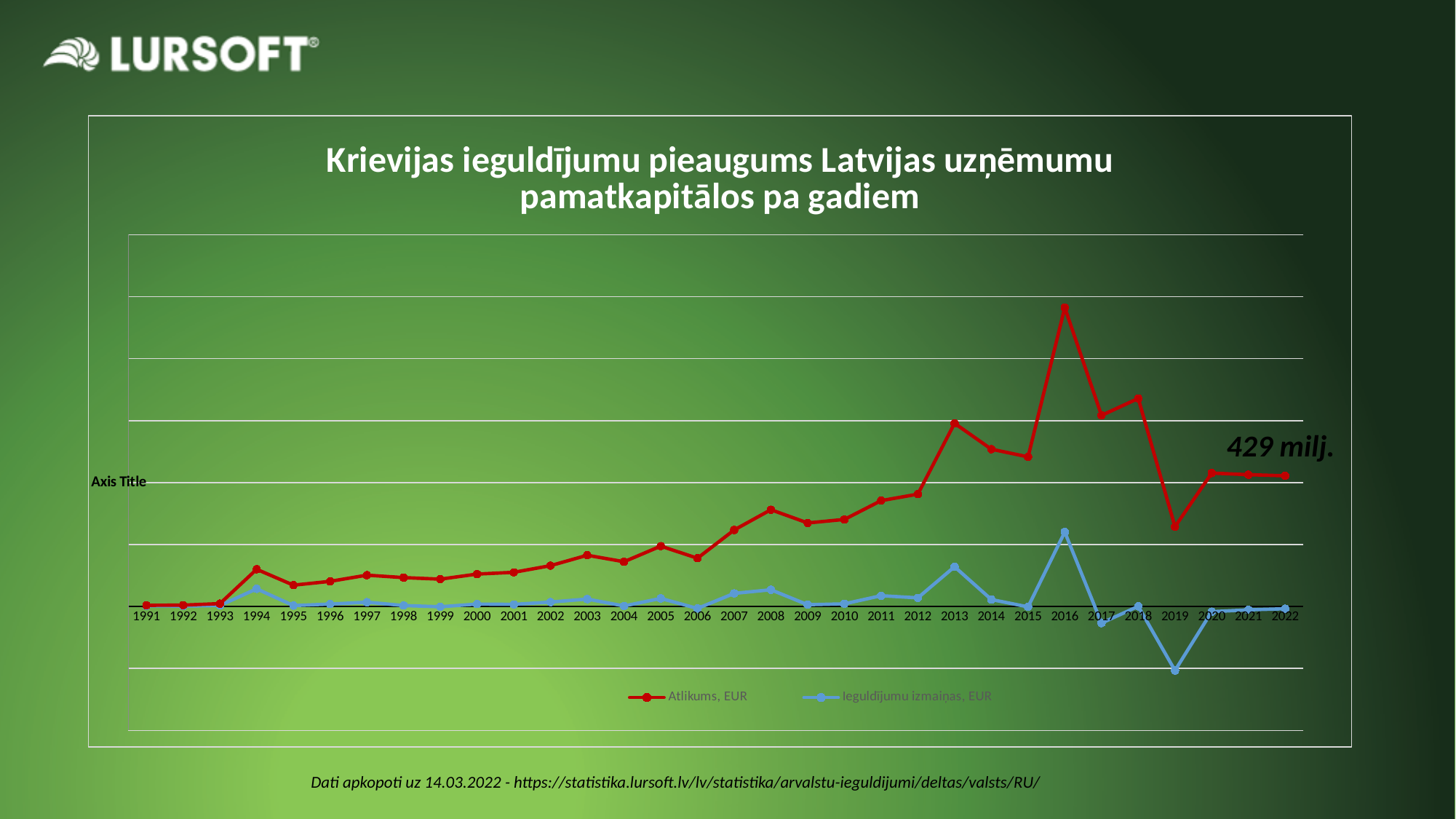
Which year has the larger Atlikums, EUR value, 2016 or 2019? 2016 Which year has the larger Ieguldījumu izmaiņas, EUR value, 2013 or 2016? 2016 What value is annotated at the end of the Atlikums, EUR line in 2022? 429 milj. What kind of chart is shown on the slide? line chart How many series does the legend list? 2 What is the title of the chart? Krievijas ieguldījumu pieaugums Latvijas uzņēmumu pamatkapitālos pa gadiem In which year does the Ieguldījumu izmaiņas, EUR series reach its highest value? 2016 In which year does the Ieguldījumu izmaiņas, EUR series reach its lowest value? 2019 In which year does the Atlikums, EUR series reach its highest value? 2016 How many years are plotted along the x axis? 32 Which colour is used for the Ieguldījumu izmaiņas, EUR series? blue Does the Atlikums, EUR series generally rise or fall from 1991 to 2016? rise